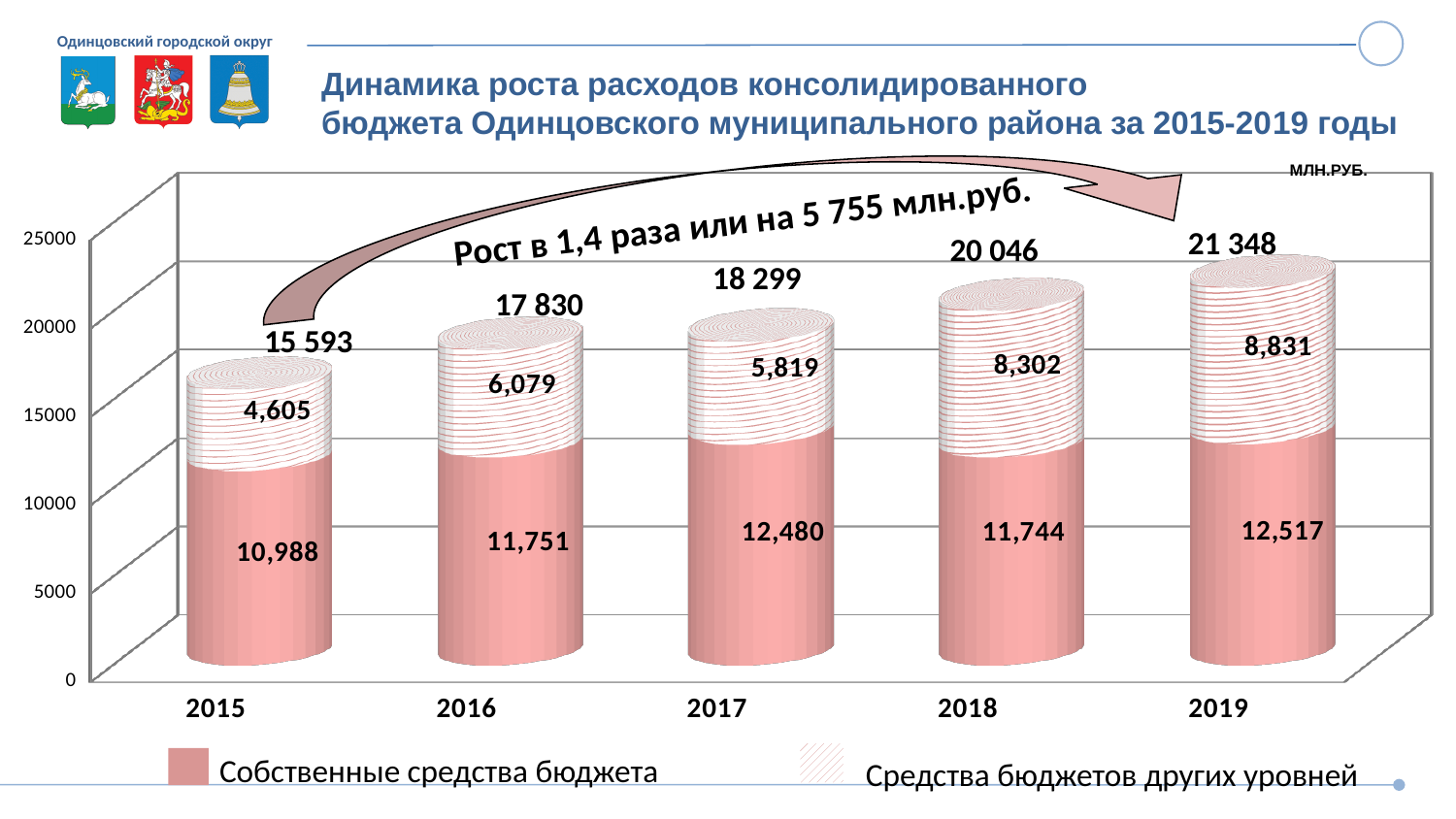
Which year has the lowest value for Средства бюджетов других уровней? 2015 Do the total budget expenditures rise or fall from 2015 to 2019? Rise What is the difference between the Собственные средства бюджета values for 2019 and 2015? 1,529 Which is larger: Средства бюджетов других уровней in 2016 or in 2017? 2016 Which year has the highest total consolidated budget expenditure? 2019 What is the total printed above the bar for 2018? 20 046 How many years are shown on the x axis? 5 What is the total of the stacked bar for 2016? 17 830 What is the value of Собственные средства бюджета for 2017? 12,480 What is the value of Средства бюджетов других уровней for 2015? 4,605 What kind of chart is shown on the slide? Stacked bar chart How many series does the legend list? 2